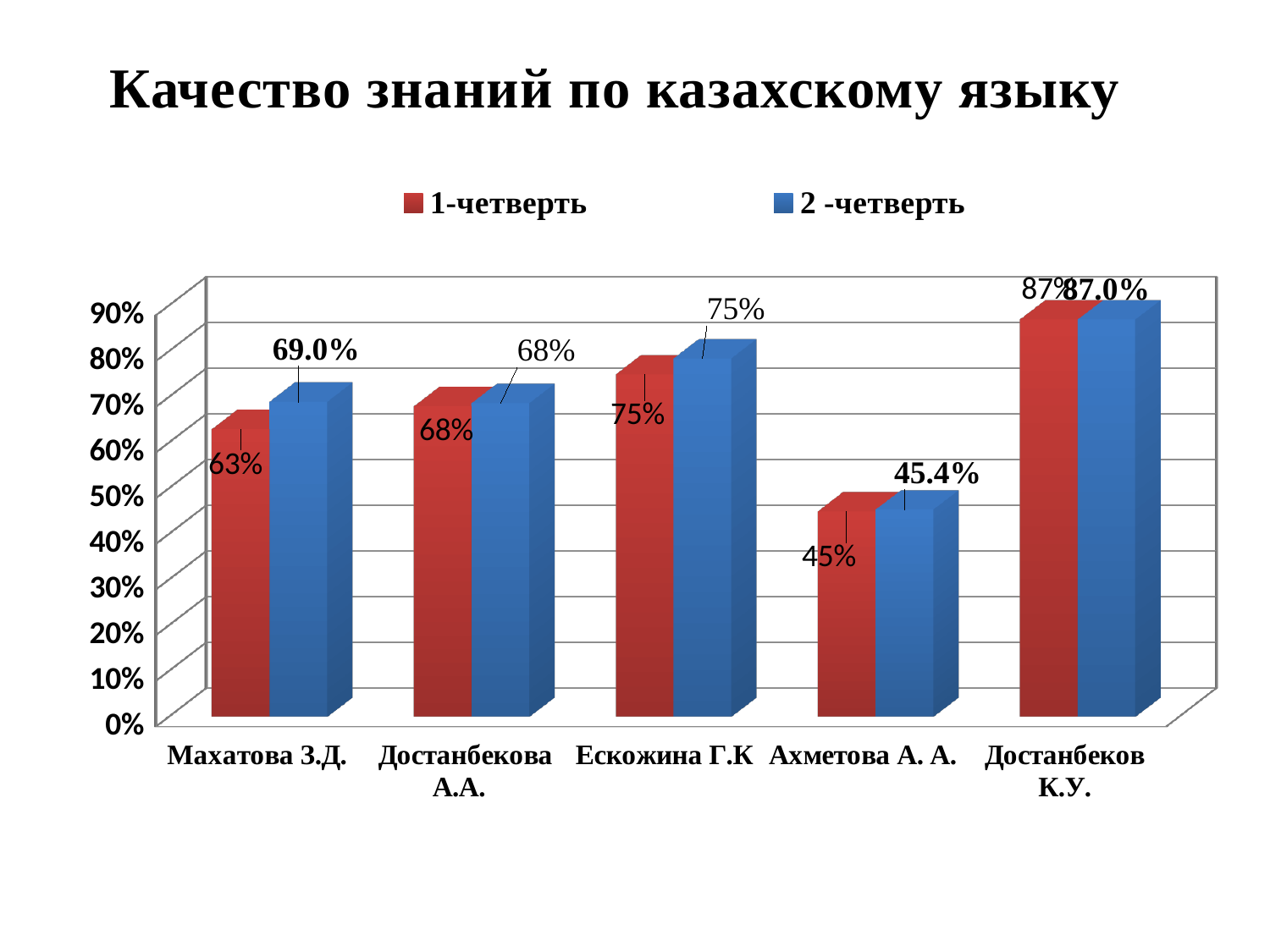
What is the value for Махатова З.Д. in 1-четверть? 63% Which is larger: the 1-четверть value for Достанбекова А.А. or the 1-четверть value for Ескожина Г.К? Ескожина Г.К Which teacher has the highest value in 1-четверть? Достанбеков К.У. What is the difference between the 1-четверть values for Достанбеков К.У. and Ахметова А. А.? 42% What is the value for Махатова З.Д. in 2 -четверть? 69.0% What type of chart is shown on the slide? bar chart What is the value for Ескожина Г.К in 1-четверть? 75% Which teacher has the lowest value in 2 -четверть? Ахметова А. А. What is the title of the chart? Качество знаний по казахскому языку How many series does the legend list? 2 How many teachers (categories) are shown on the x axis? 5 What is the value for Ахметова А. А. in 2 -четверть? 45.4%